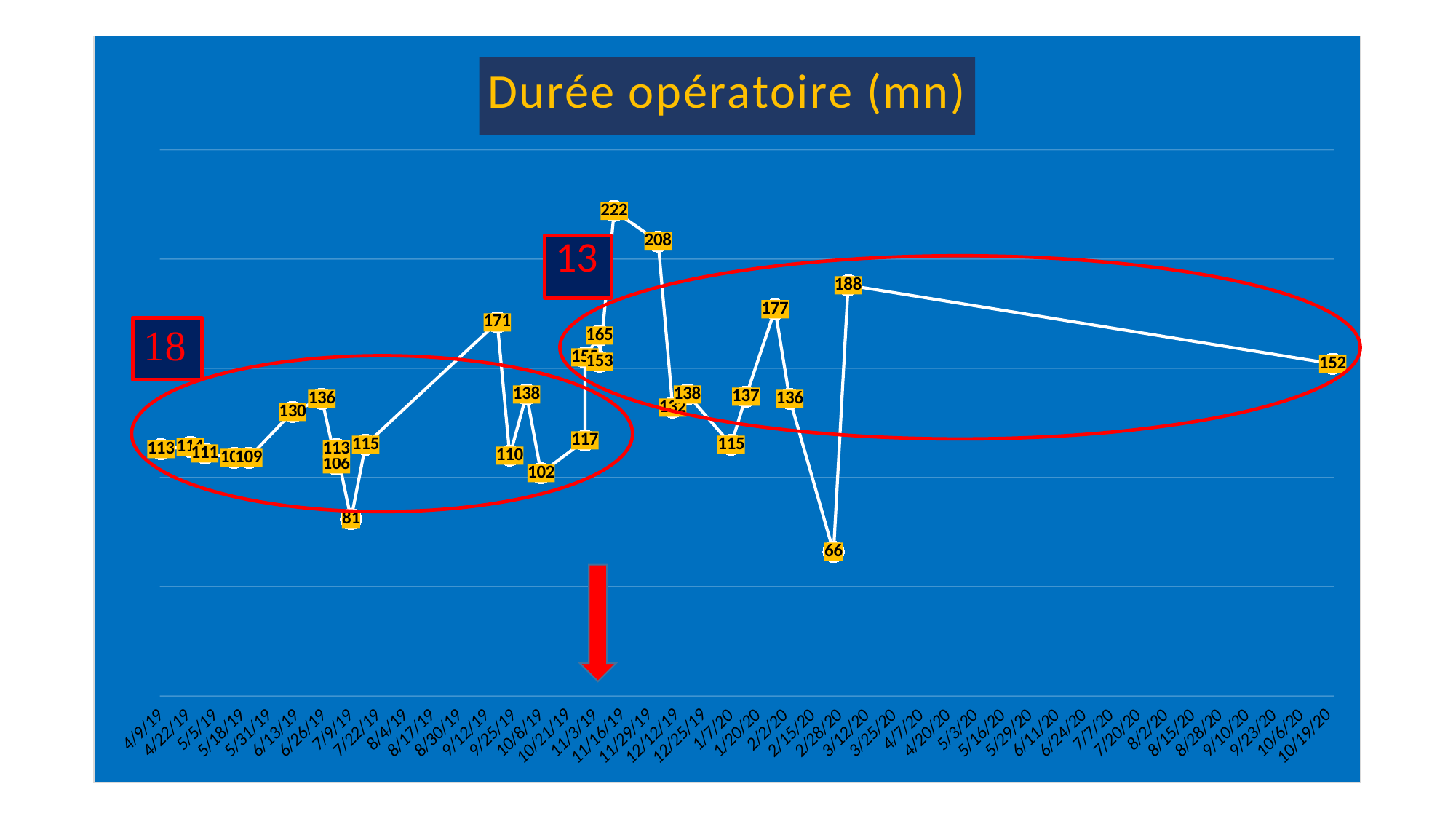
What two numbers appear in the dark boxes above the red ellipses? 18 and 13 How many lines are plotted on the chart? 1 What is the lowest value plotted on the chart? 66 What is the highest value plotted on the chart? 222 What is the title of the chart? Durée opératoire (mn) What is the difference between the data point labelled 188 and the final data point labelled 152? 36 Which is larger, the data point labelled 177 or the data point labelled 188? 188 What is the value of the data point immediately following the low of 66? 188 What kind of chart is shown on the slide? line chart What is the value of the last data point on the chart, near 10/19/20? 152 What is the difference between the highest value (222) and the lowest value (66) on the chart? 156 What is the value of the data point immediately following the peak of 222? 208